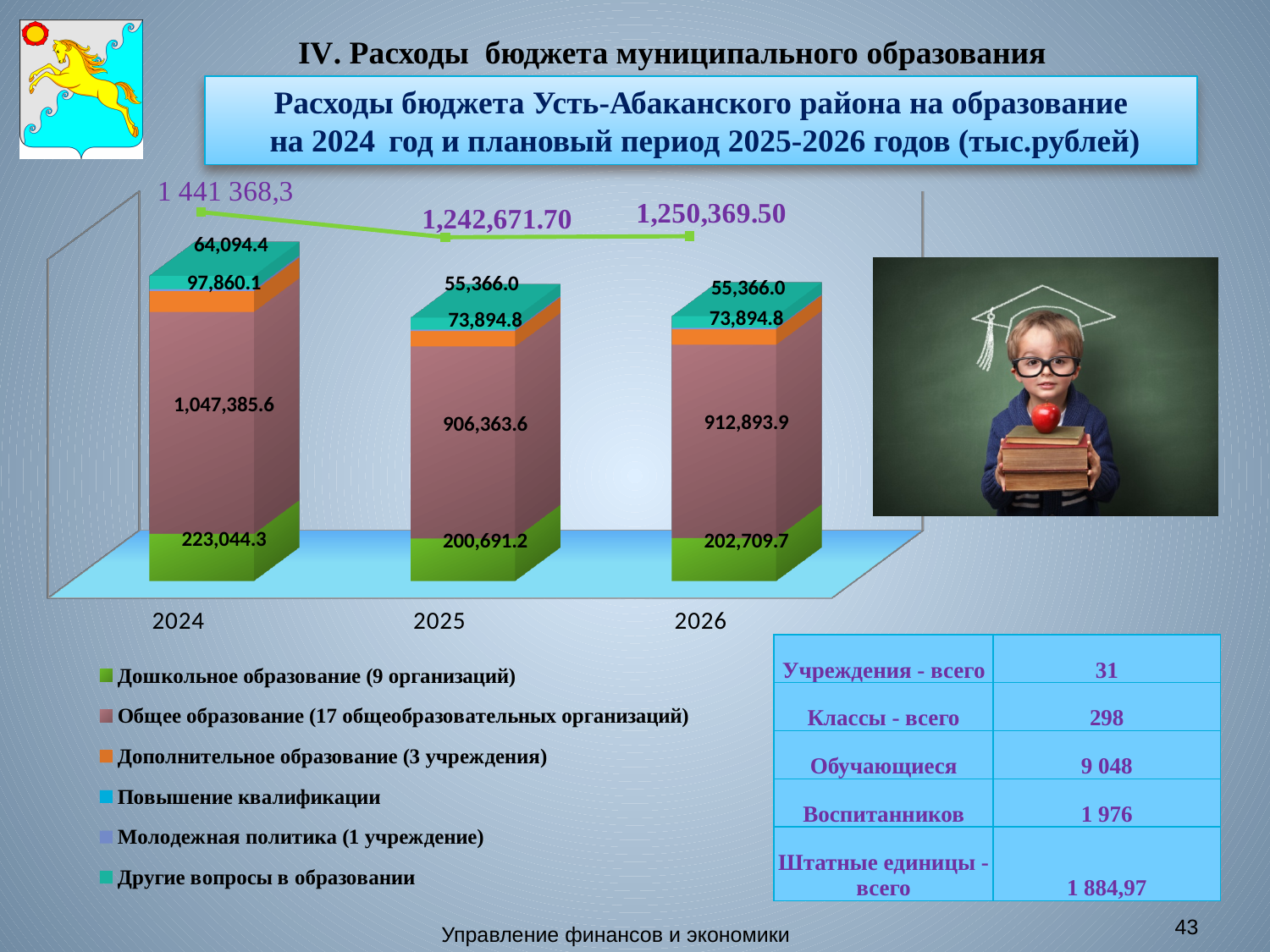
What kind of chart is used to show the education expenditure? Stacked bar chart Which year has the highest value for Общее образование? 2024 How many years are shown on the x axis of the chart? 3 Which year has the lowest value for Дошкольное образование? 2025 Is the value for Общее образование larger in 2025 or in 2026? 2026 What is the value for Общее образование in 2024? 1,047,385.6 How many series does the legend list? 6 What is the value for Общее образование in 2026? 912,893.9 What is the difference between the Дошкольное образование values for 2024 and 2025? 22,353.1 What is the value for Дошкольное образование in 2025? 200,691.2 What is the total education expenditure shown for 2026? 1,250,369.50 What is the total education expenditure shown for 2024? 1 441 368,3